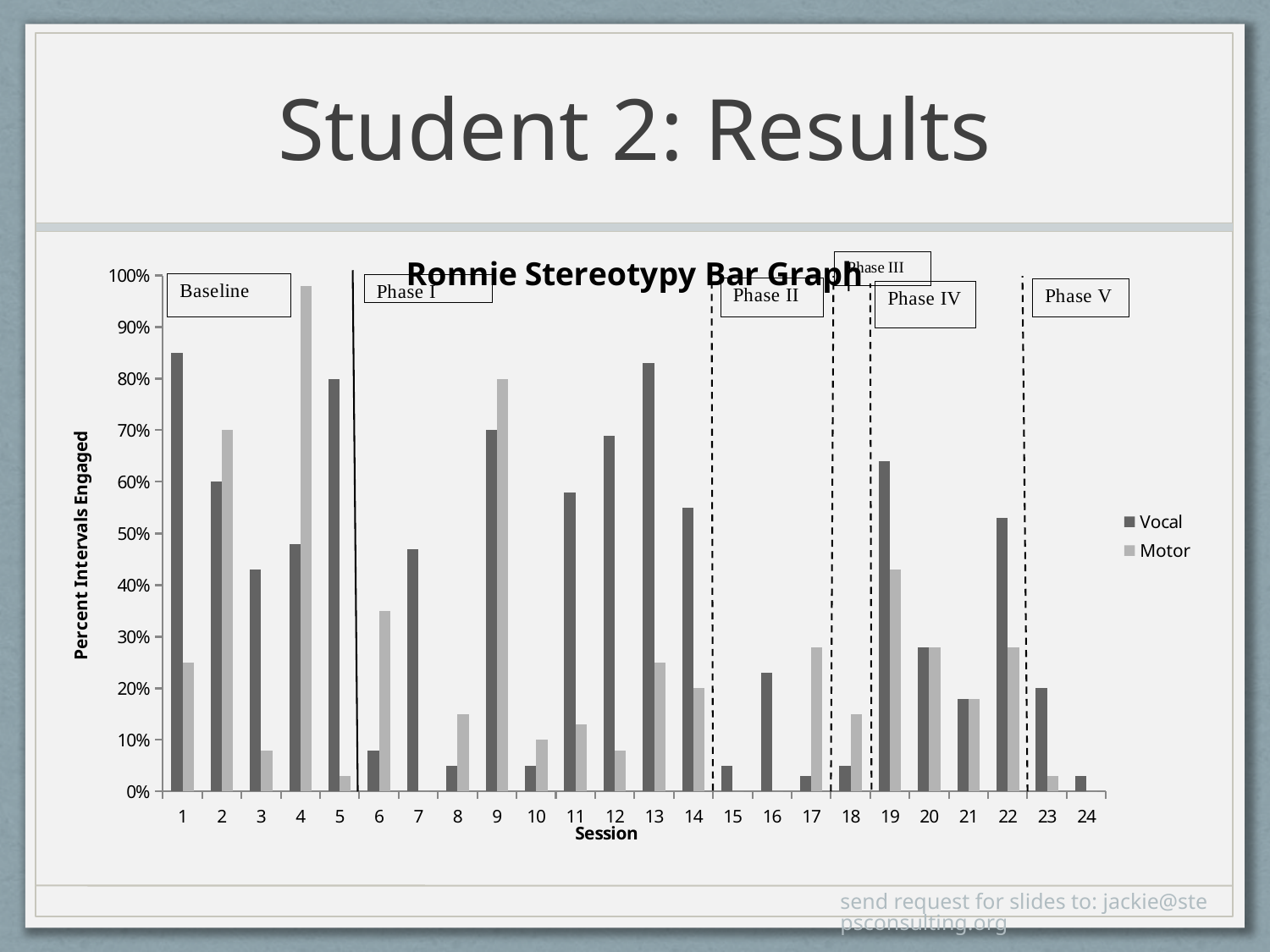
What kind of chart is shown on the slide? Bar chart In session 5, which is larger, the Vocal value or the Motor value? Vocal Which session has the highest Motor value? Session 4 Is the Motor value for session 4 greater or less than 90%? greater How many sessions are shown along the x axis? 24 Is the Vocal value for session 16 greater or less than 30%? less In session 17, which is larger, the Vocal value or the Motor value? Motor What is the title of the chart? Ronnie Stereotypy Bar Graph Is the Vocal value for session 1 greater or less than 70%? greater How many series does the legend list? 2 What is the label on the vertical axis? Percent Intervals Engaged